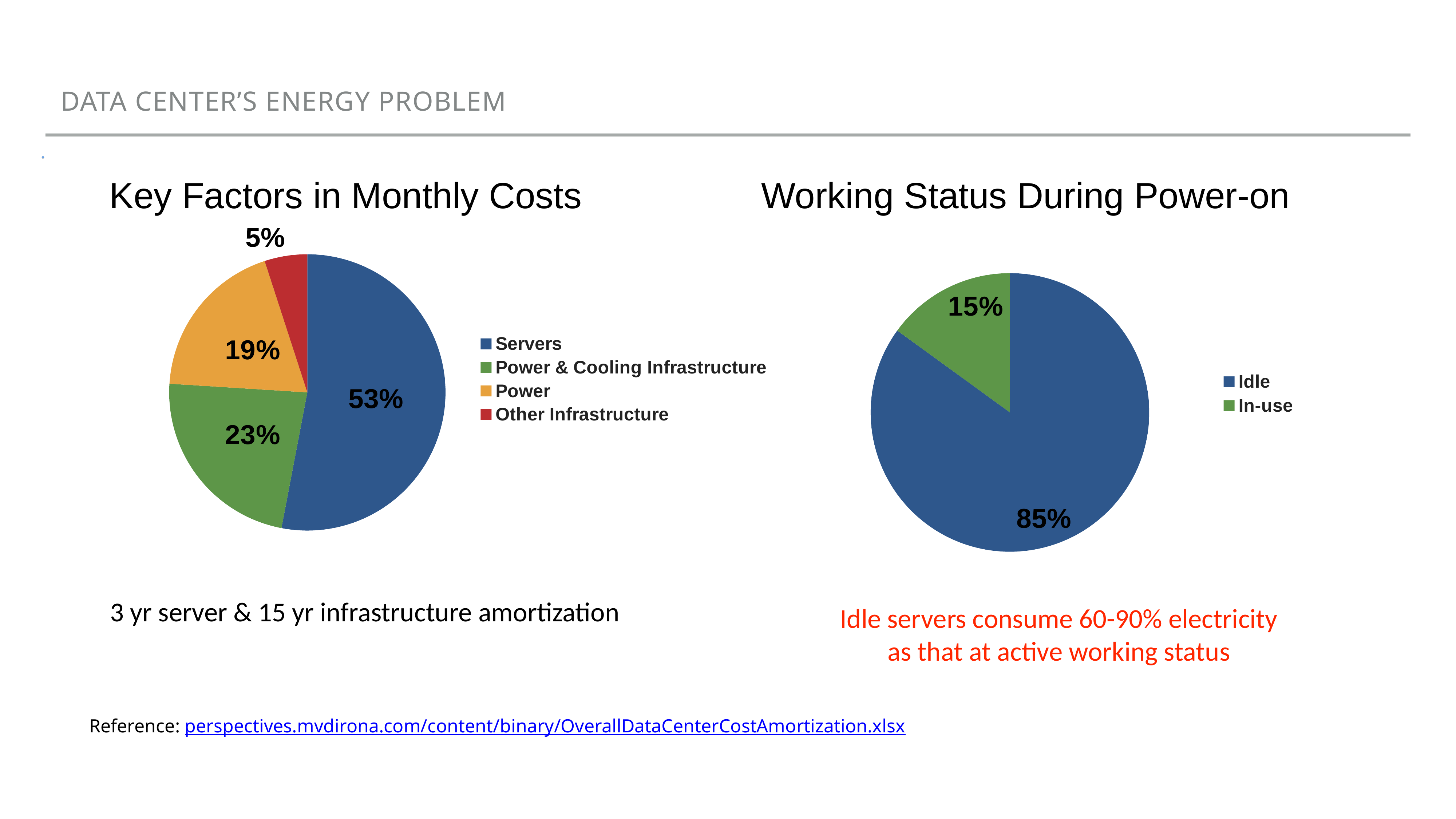
What type of chart is 'Working Status During Power-on'? Pie chart In the 'Working Status During Power-on' chart, which is larger, Idle or In-use? Idle In the 'Key Factors in Monthly Costs' chart, what share of monthly costs is attributed to Servers? 53% In the 'Key Factors in Monthly Costs' chart, what percentage is shown for Power? 19% In the 'Key Factors in Monthly Costs' chart, which category has the smallest share? Other Infrastructure In the 'Working Status During Power-on' chart, what percentage of time are servers Idle? 85% In the 'Key Factors in Monthly Costs' chart, which category has the largest share? Servers In the 'Key Factors in Monthly Costs' chart, what percentage is shown for Power & Cooling Infrastructure? 23% In the 'Working Status During Power-on' chart, what percentage is shown for In-use? 15% In the 'Key Factors in Monthly Costs' chart, how many categories does the legend list? 4 In the 'Key Factors in Monthly Costs' chart, how many percentage points larger is the Servers share than the Power share? 34 In the 'Working Status During Power-on' chart, what colour represents In-use? Green